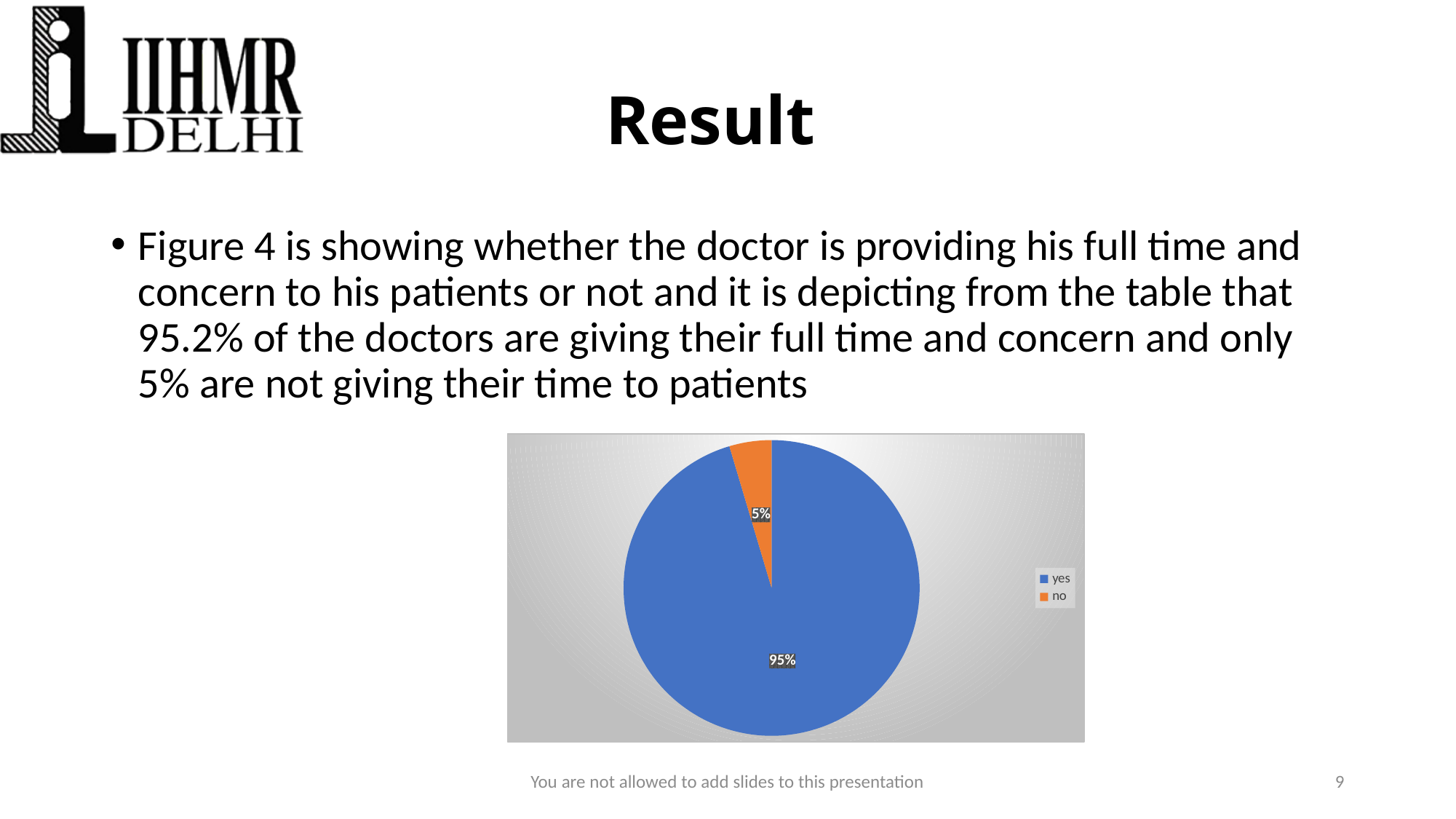
How many slices does the pie chart have? 2 Which slice is larger, 'yes' or 'no'? yes What colour is the 'no' slice in the pie chart? orange What colour is the 'yes' slice in the pie chart? blue What kind of chart is shown on the slide? pie chart How many entries does the legend of the pie chart list? 2 Which slice of the pie chart is the smallest? no What percentage of the pie chart is labelled for the 'no' slice? 5% What is the difference in percentage points between the 'yes' and 'no' slices? 90 What percentage of the pie chart is labelled for the 'yes' slice? 95% Which slice of the pie chart is the largest? yes What share of the pie does the 'no' slice represent? 5%